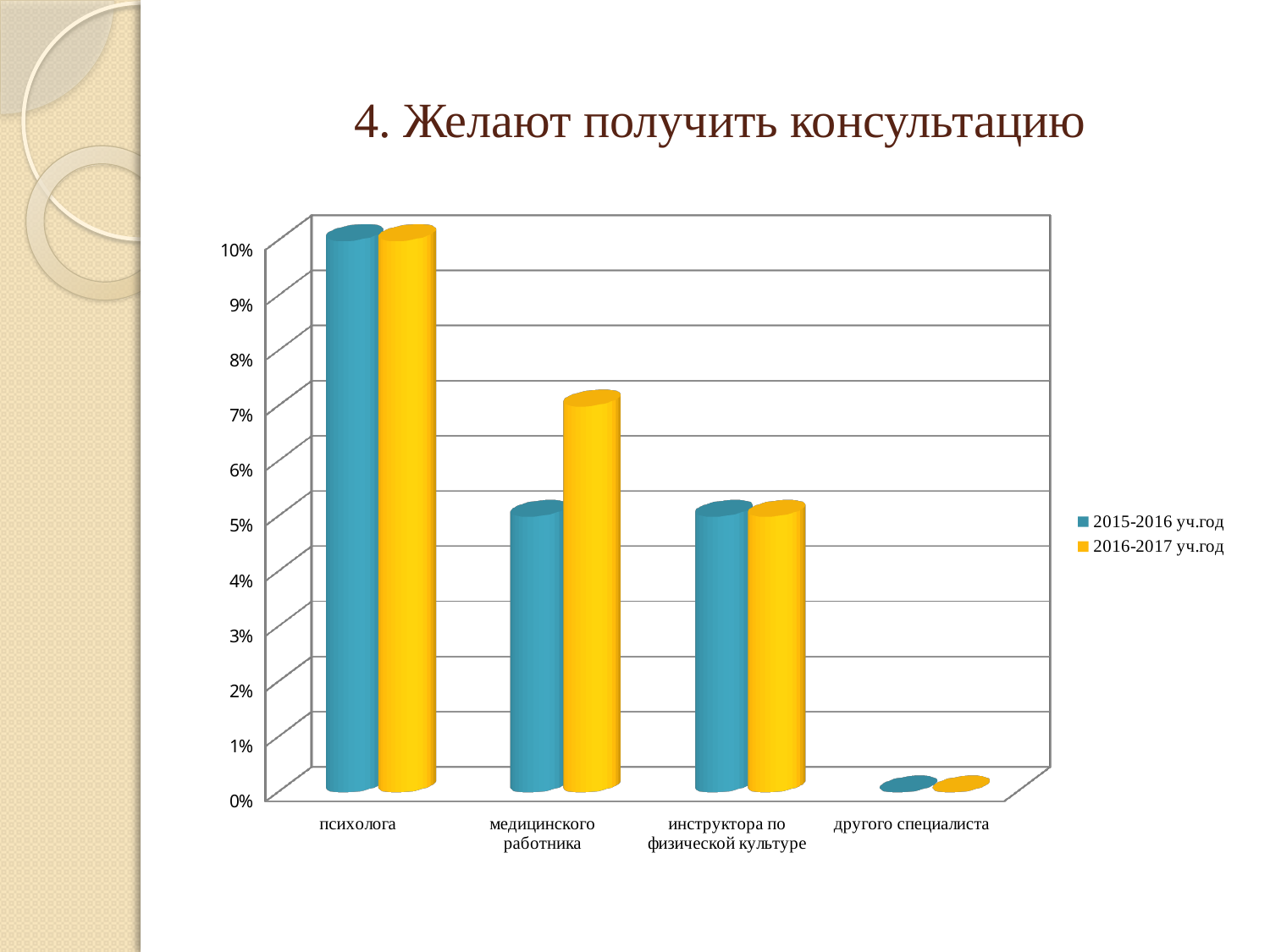
What kind of chart is shown on the slide? bar chart How many series does the legend list? 2 Is the value for инструктора по физической культуре in the 2016-2017 уч.год series greater or less than 8%? less What is the value for психолога in the 2015-2016 уч.год series? 10% What is the value for медицинского работника in the 2015-2016 уч.год series? 5% Which category has the highest value in the 2016-2017 уч.год series? психолога Which category has the lowest value in the 2015-2016 уч.год series? другого специалиста What is the difference between the 2016-2017 уч.год and 2015-2016 уч.год values for медицинского работника? 2% What is the value for медицинского работника in the 2016-2017 уч.год series? 7% For медицинского работника, which series has the larger value, 2015-2016 уч.год or 2016-2017 уч.год? 2016-2017 уч.год How many categories are shown on the x axis? 4 What is the title of the chart on the slide? 4. Желают получить консультацию